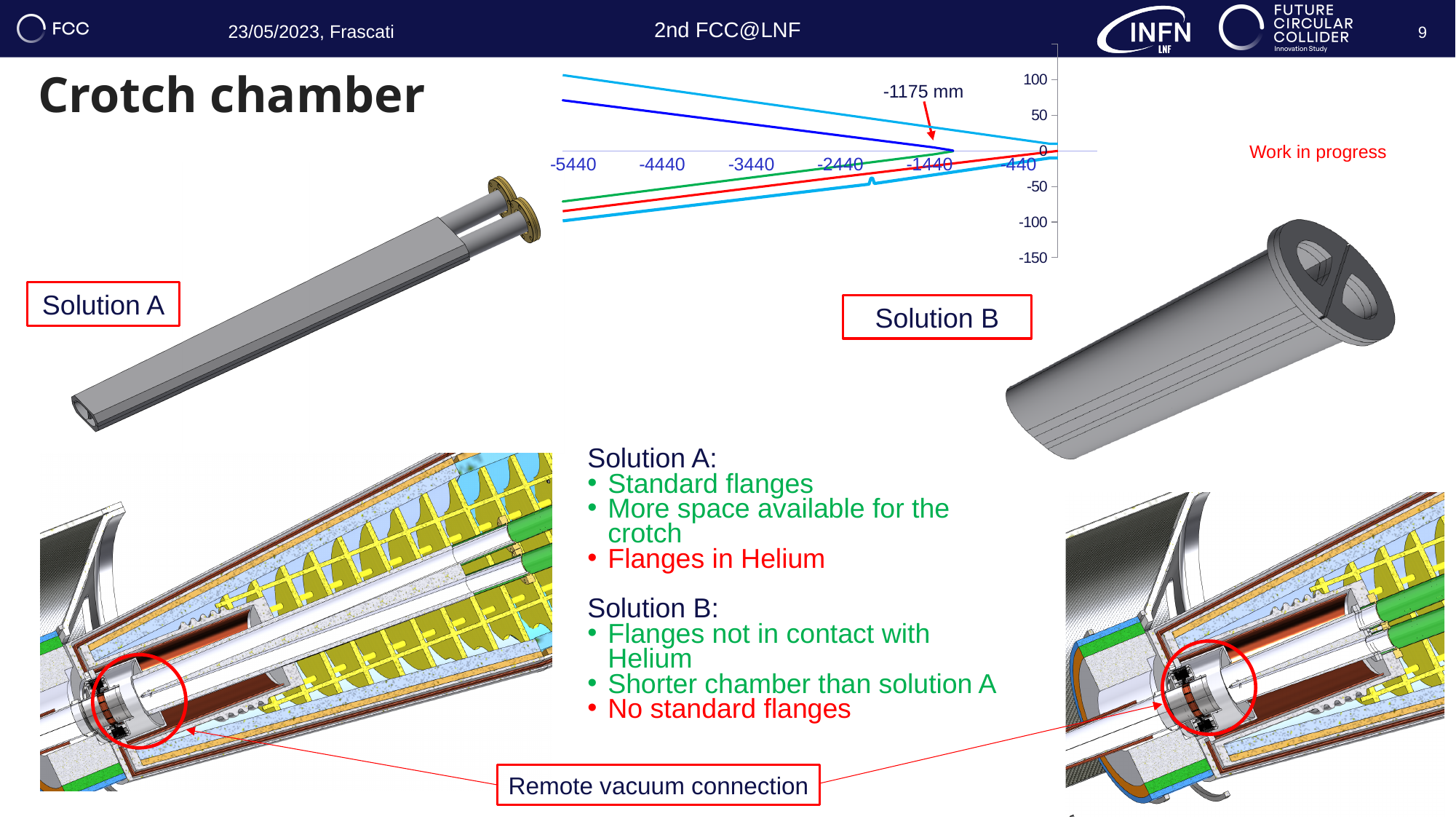
In the line chart at the top of the slide, which line is higher at -5440: the upper light blue line or the dark blue line? the upper light blue line In the line chart at the top of the slide, does the red line rise or fall as it goes from left to right toward 0? rise How many tick labels are printed on the horizontal axis of the line chart at the top of the slide? 6 In the line chart at the top of the slide, is the value of the dark blue line at -5440 greater or less than 50? greater In the line chart at the top of the slide, what value does the red arrow annotation indicate? -1175 mm What kind of chart is shown at the top of the slide next to the 'Crotch chamber' title? line chart In the line chart at the top of the slide, what is the highest tick label on the vertical axis? 100 In the line chart at the top of the slide, what is the lowest tick label on the vertical axis? -150 In the line chart at the top of the slide, which line is lower at -5440: the red line or the green line? the red line In the line chart at the top of the slide, what is the leftmost tick label on the horizontal axis? -5440 In the line chart at the top of the slide, does the upper light blue line rise or fall as it goes from left to right toward 0? fall In the line chart at the top of the slide, is the value of the lower light blue line at -5440 greater or less than -50? less